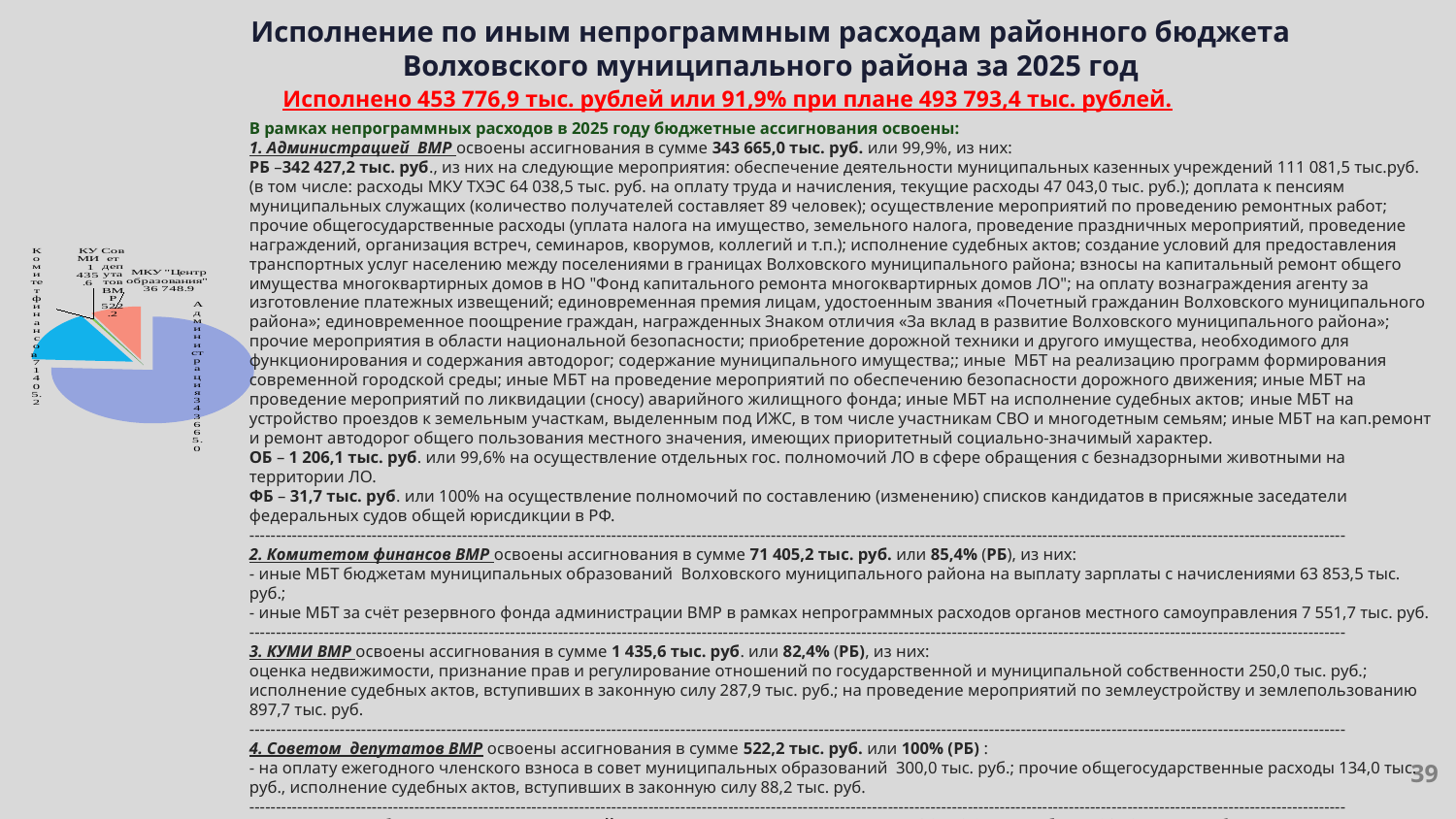
What kind of chart is shown on the left of the slide? pie chart In the pie chart, which category has the largest slice? Администрация In the pie chart, what value is shown for Администрация ВМР? 343665.0 What colour is the largest slice of the pie chart? lavender (light purple-blue) In the pie chart, what is the difference between the values for Комитет финансов and МКУ "Центр образования"? 34656.3 In the pie chart, what value is shown for МКУ "Центр образования"? 36 748.9 In the pie chart, what is the difference between the values for Администрация ВМР and Комитет финансов? 272259.8 In the pie chart, which is larger: the slice for Администрация ВМР or the slice for Комитет финансов? Администрация ВМР In the pie chart, which is larger: the slice for Комитет финансов or the slice for МКУ "Центр образования"? Комитет финансов In the pie chart, what value is shown for Комитет финансов? 71405.2